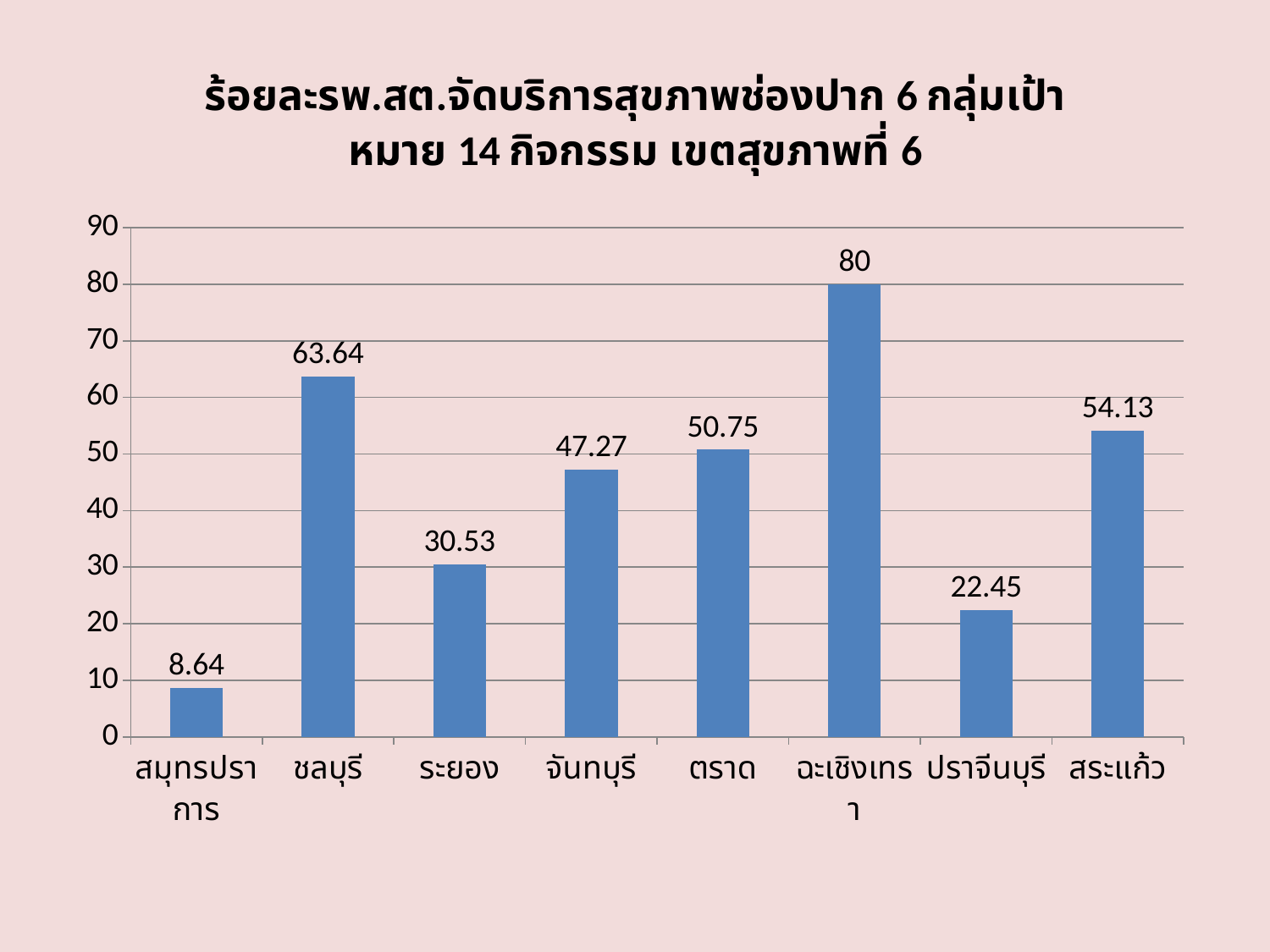
What colour are the bars in the chart? blue What is the value for ชลบุรี? 63.64 Which province has the highest value? ฉะเชิงเทรา Which province has the lowest value? สมุทรปราการ What is the value for สระแก้ว? 54.13 What kind of chart is shown on the slide? bar chart Which is larger, the value for ระยอง or the value for ปราจีนบุรี? ระยอง Is the value for ตราด greater or less than 40? greater What is the difference between the values for ฉะเชิงเทรา and ชลบุรี? 16.36 What is the value for ปราจีนบุรี? 22.45 What is the difference between the values for ตราด and จันทบุรี? 3.48 How many provinces are shown on the x axis? 8